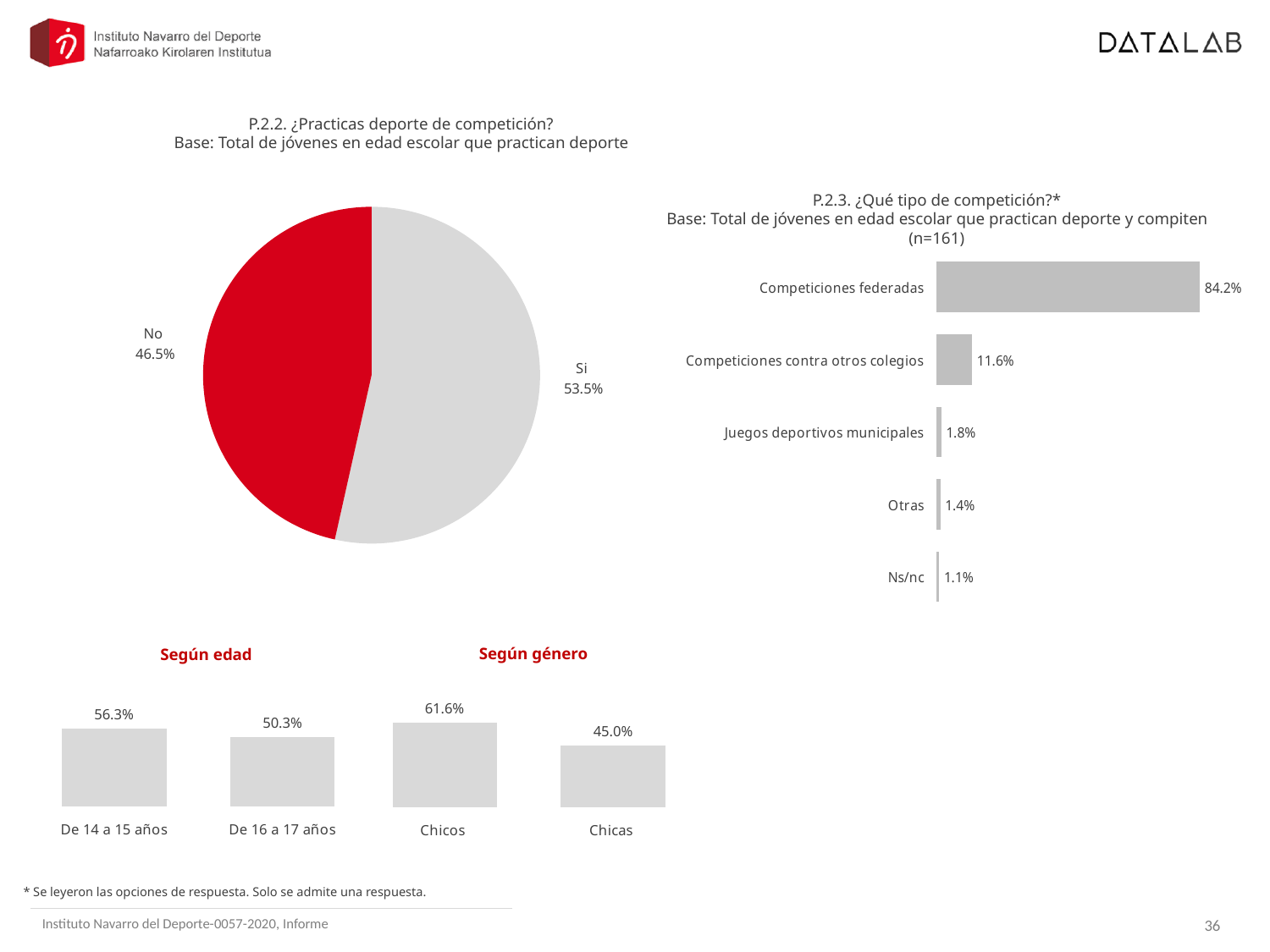
In the pie chart 'P.2.2. ¿Practicas deporte de competición?', what percentage answered 'Si'? 53.5% In the bar chart 'P.2.3. ¿Qué tipo de competición?', which category has the lowest value? Ns/nc In the pie chart 'P.2.2. ¿Practicas deporte de competición?', what percentage answered 'No'? 46.5% In the bar chart 'P.2.3. ¿Qué tipo de competición?', what is the difference between 'Competiciones federadas' and 'Competiciones contra otros colegios'? 72.6 percentage points In the 'Según edad' chart, what is the value for 'De 14 a 15 años'? 56.3% In the bar chart 'P.2.3. ¿Qué tipo de competición?', what is the value for 'Competiciones federadas'? 84.2% In the 'Según género' chart, what is the difference between 'Chicos' and 'Chicas'? 16.6 percentage points In the pie chart 'P.2.2. ¿Practicas deporte de competición?', what colour is the 'No' slice? Red In the bar chart 'P.2.3. ¿Qué tipo de competición?', how many categories are shown? 5 In the pie chart 'P.2.2. ¿Practicas deporte de competición?', which slice is larger, 'Si' or 'No'? Si In the bar chart 'P.2.3. ¿Qué tipo de competición?', what is the value for 'Competiciones contra otros colegios'? 11.6% What kind of chart is 'P.2.3. ¿Qué tipo de competición?'? Bar chart